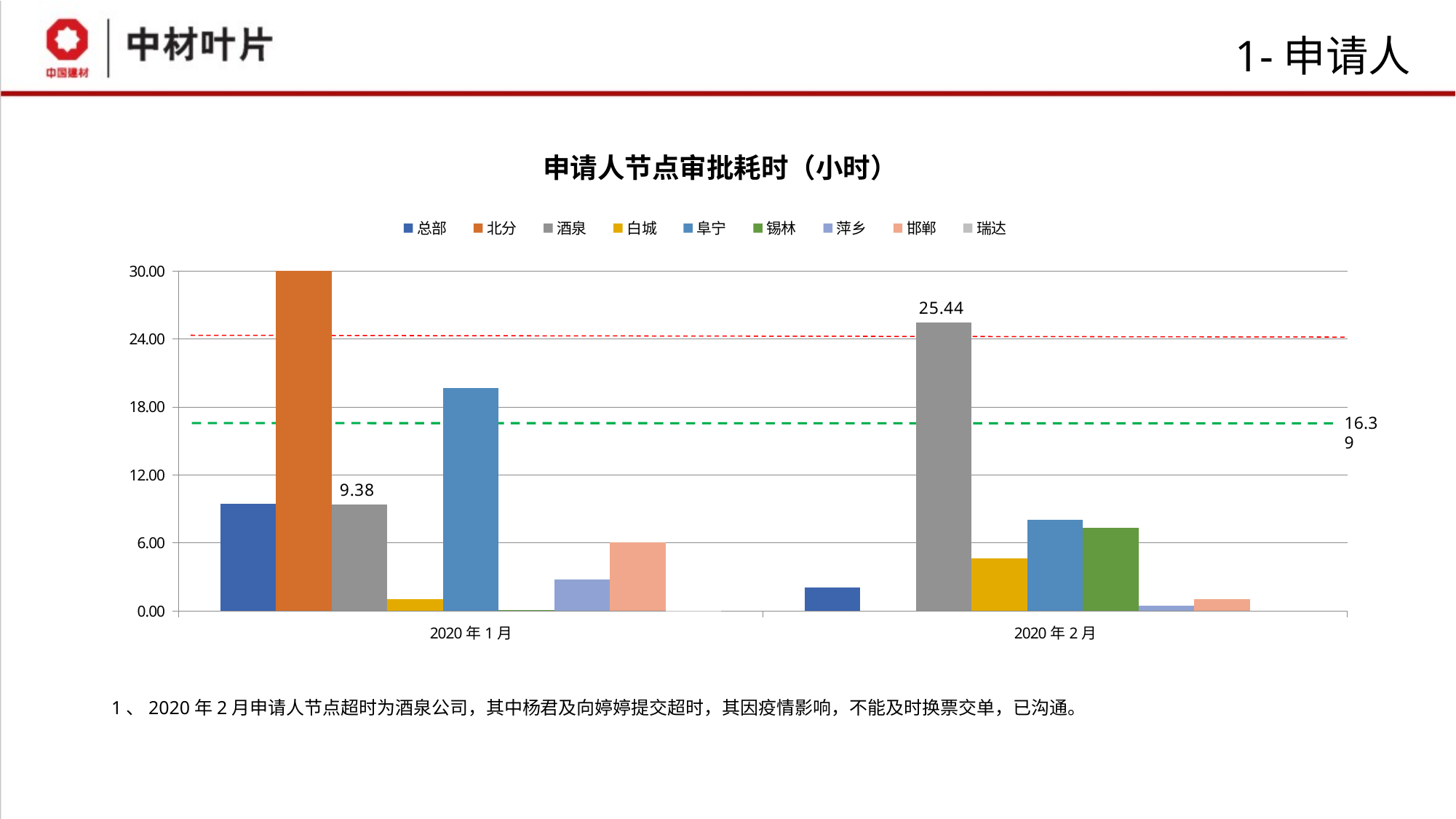
How many categories are shown on the x axis? 2 What is the value for 酒泉 in 2020年1月? 9.38 How many series does the legend list? 9 Does the value for 酒泉 rise or fall from 2020年1月 to 2020年2月? rise Which is larger for 酒泉: the value in 2020年1月 or in 2020年2月? 2020年2月 Which series has the highest value in 2020年2月? 酒泉 Which series has the highest value in 2020年1月? 北分 Is the value for 阜宁 in 2020年1月 greater or less than 18.00? greater What value is labelled on the green dashed line? 16.39 What kind of chart is shown on the slide? bar chart What is the value for 酒泉 in 2020年2月? 25.44 What is the difference between the 酒泉 values for 2020年2月 and 2020年1月? 16.06